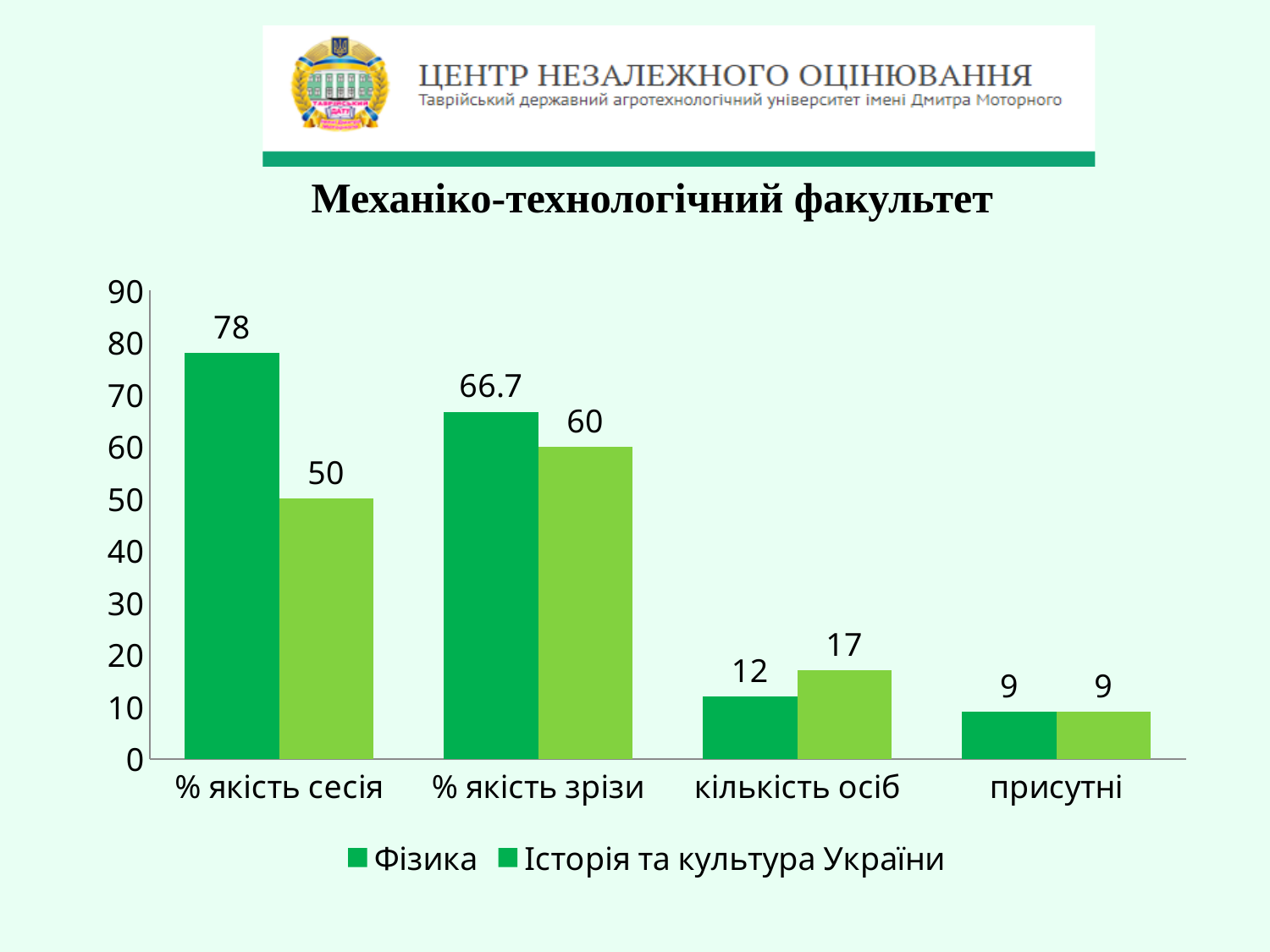
In the кількість осіб category, which series has the larger value, Фізика or Історія та культура України? Історія та культура України How many categories are shown on the x axis? 4 What is the value for Історія та культура України in the % якість зрізи category? 60 What kind of chart is shown on the slide? bar chart Which category has the highest value for Фізика? % якість сесія What is the value for Історія та культура України in the присутні category? 9 Which category has the lowest value for Історія та культура України? присутні What is the title of the slide above the chart? Механіко-технологічний факультет What is the value for Фізика in the кількість осіб category? 12 What is the difference between the Фізика and Історія та культура України values in the % якість сесія category? 28 How many series does the legend list? 2 What is the value for Фізика in the % якість сесія category? 78